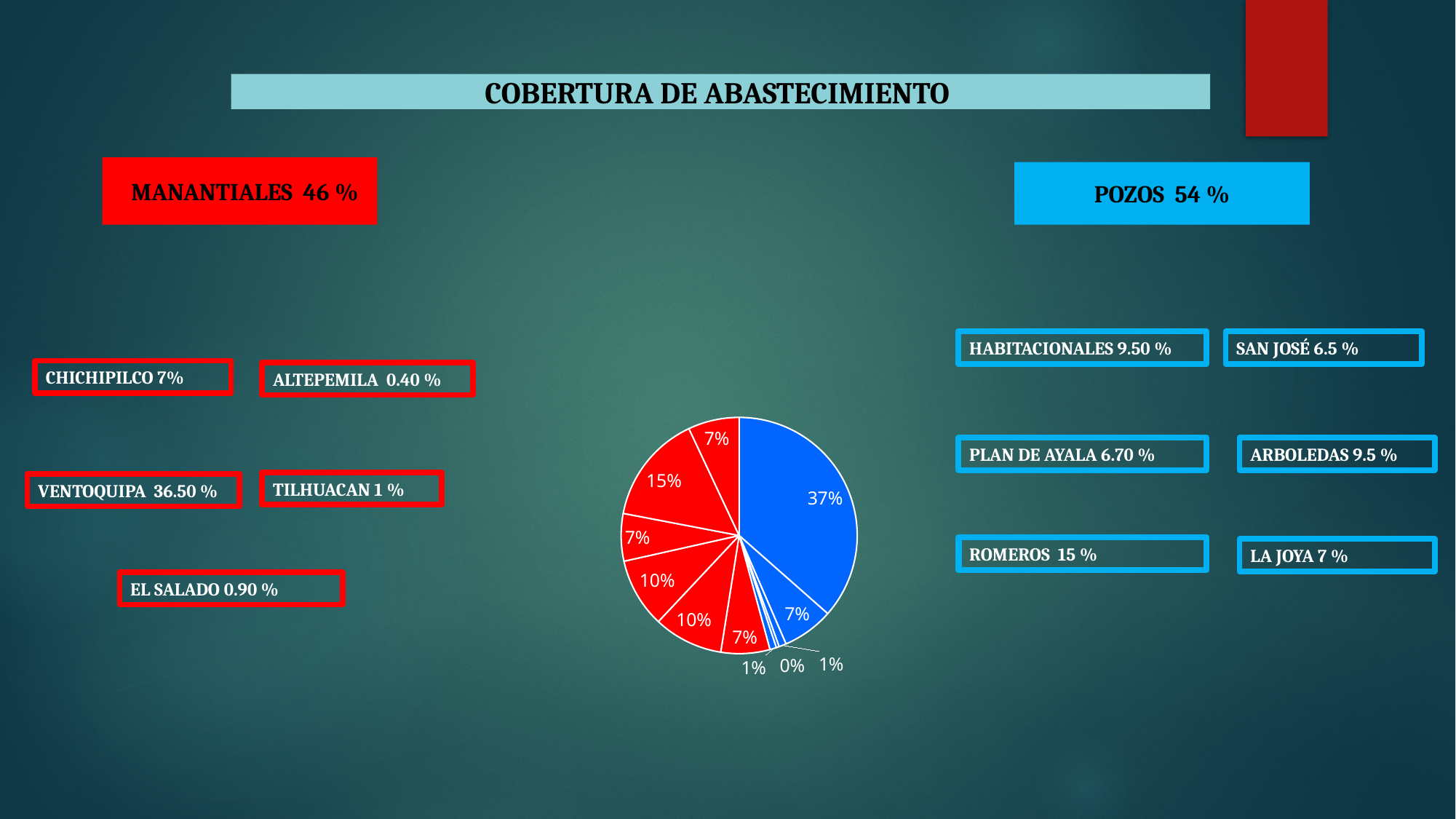
Is the largest slice of the pie chart greater or less than 50%? less What is the difference between the largest slice (37%) and the largest red slice (15%) in the pie chart? 22% How many slices does the pie chart have? 11 How many slices in the pie chart are labeled 10%? 2 What is the percentage label of the largest slice in the pie chart? 37% How many slices in the pie chart are labeled 7%? 4 What is the label of the largest red slice in the pie chart? 15% Which is larger, the largest blue slice or the largest red slice of the pie chart? the largest blue slice Is the largest slice of the pie chart red or blue? blue What is the smallest percentage label shown on the pie chart? 0% What heading appears in the banner above the pie chart? COBERTURA DE ABASTECIMIENTO What kind of chart is shown on the slide? pie chart